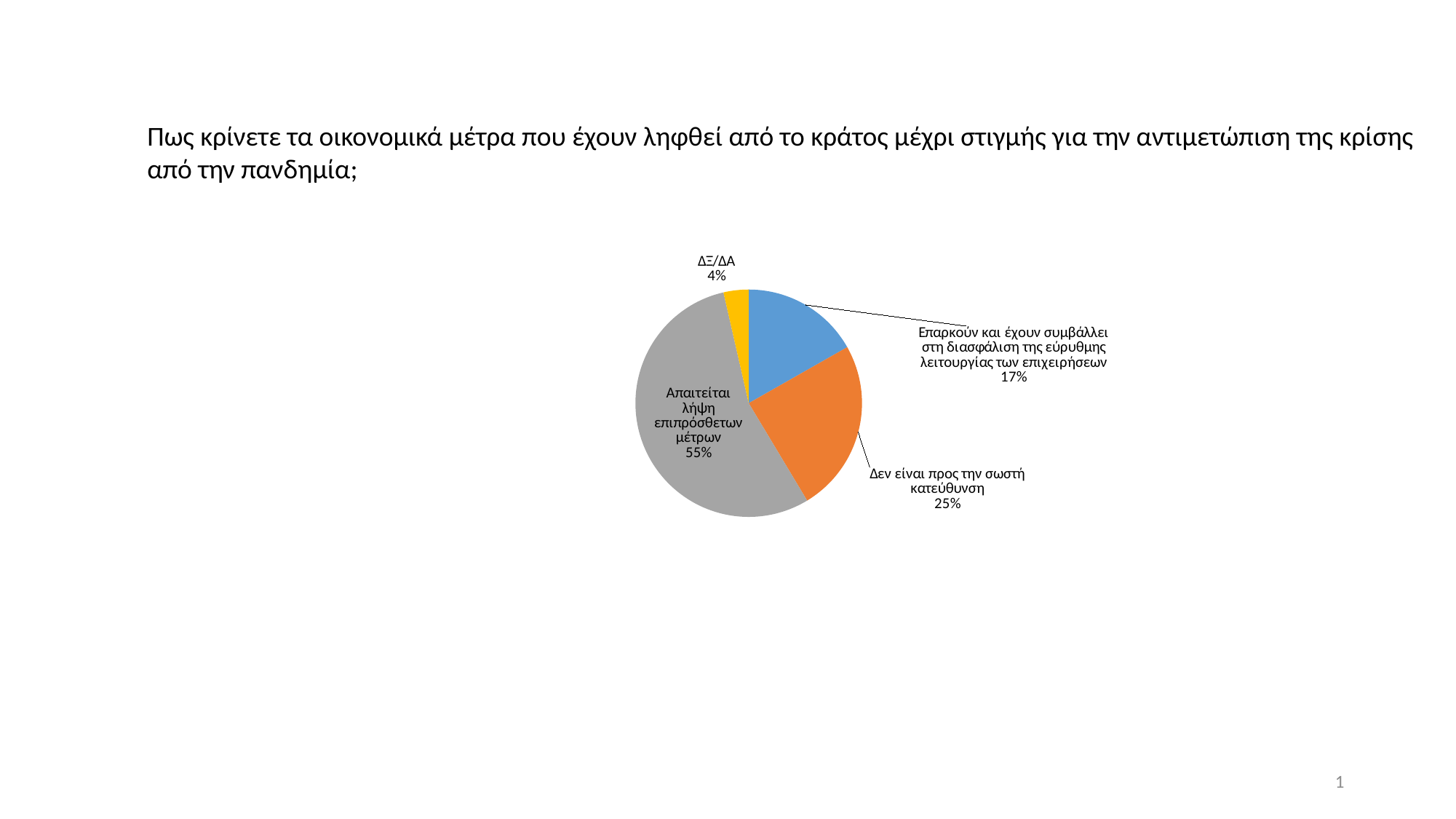
How many slices does the pie chart have? 4 What is the difference between the 'Επαρκούν και έχουν συμβάλλει στη διασφάλιση της εύρυθμης λειτουργίας των επιχειρήσεων' slice and the 'ΔΞ/ΔΑ' slice? 13% What is the value shown for 'Δεν είναι προς την σωστή κατεύθυνση'? 25% What is the value shown for 'Επαρκούν και έχουν συμβάλλει στη διασφάλιση της εύρυθμης λειτουργίας των επιχειρήσεων'? 17% Which is larger: 'Δεν είναι προς την σωστή κατεύθυνση' or 'Επαρκούν και έχουν συμβάλλει στη διασφάλιση της εύρυθμης λειτουργίας των επιχειρήσεων'? Δεν είναι προς την σωστή κατεύθυνση What is the value shown for 'ΔΞ/ΔΑ'? 4% What colour is the 'Απαιτείται λήψη επιπρόσθετων μέτρων' slice? Grey Which slice of the pie is the largest? Απαιτείται λήψη επιπρόσθετων μέτρων Which slice of the pie is the smallest? ΔΞ/ΔΑ What is the difference between the 'Απαιτείται λήψη επιπρόσθετων μέτρων' slice and the 'Δεν είναι προς την σωστή κατεύθυνση' slice? 30% What share of the pie does the slice 'Απαιτείται λήψη επιπρόσθετων μέτρων' represent? 55% What kind of chart is shown on the slide? Pie chart